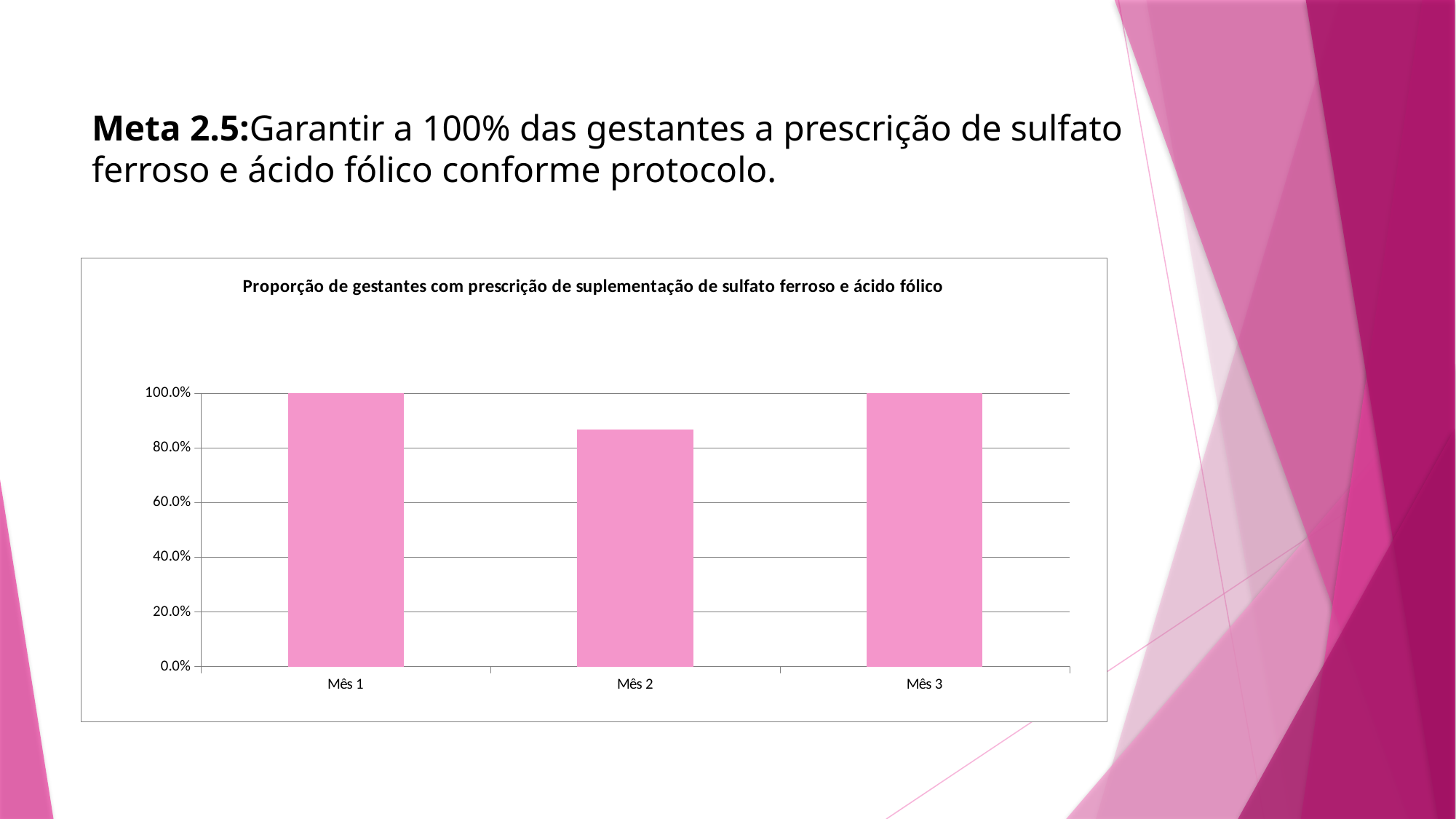
Which month has the lowest value? Mês 2 Which is larger, the value for Mês 1 or the value for Mês 2? Mês 1 Is the value for Mês 2 greater or less than 100.0%? less Which is larger, the value for Mês 2 or the value for Mês 3? Mês 3 Does the value fall or rise from Mês 2 to Mês 3? Rise What is the value for Mês 3? 100.0% Is the value for Mês 2 greater or less than 80.0%? greater What is the value for Mês 1? 100.0% What is the title of the chart? Proporção de gestantes com prescrição de suplementação de sulfato ferroso e ácido fólico What colour are the bars in the chart? Pink What kind of chart is shown on the slide? Bar chart How many months are shown on the x axis? 3